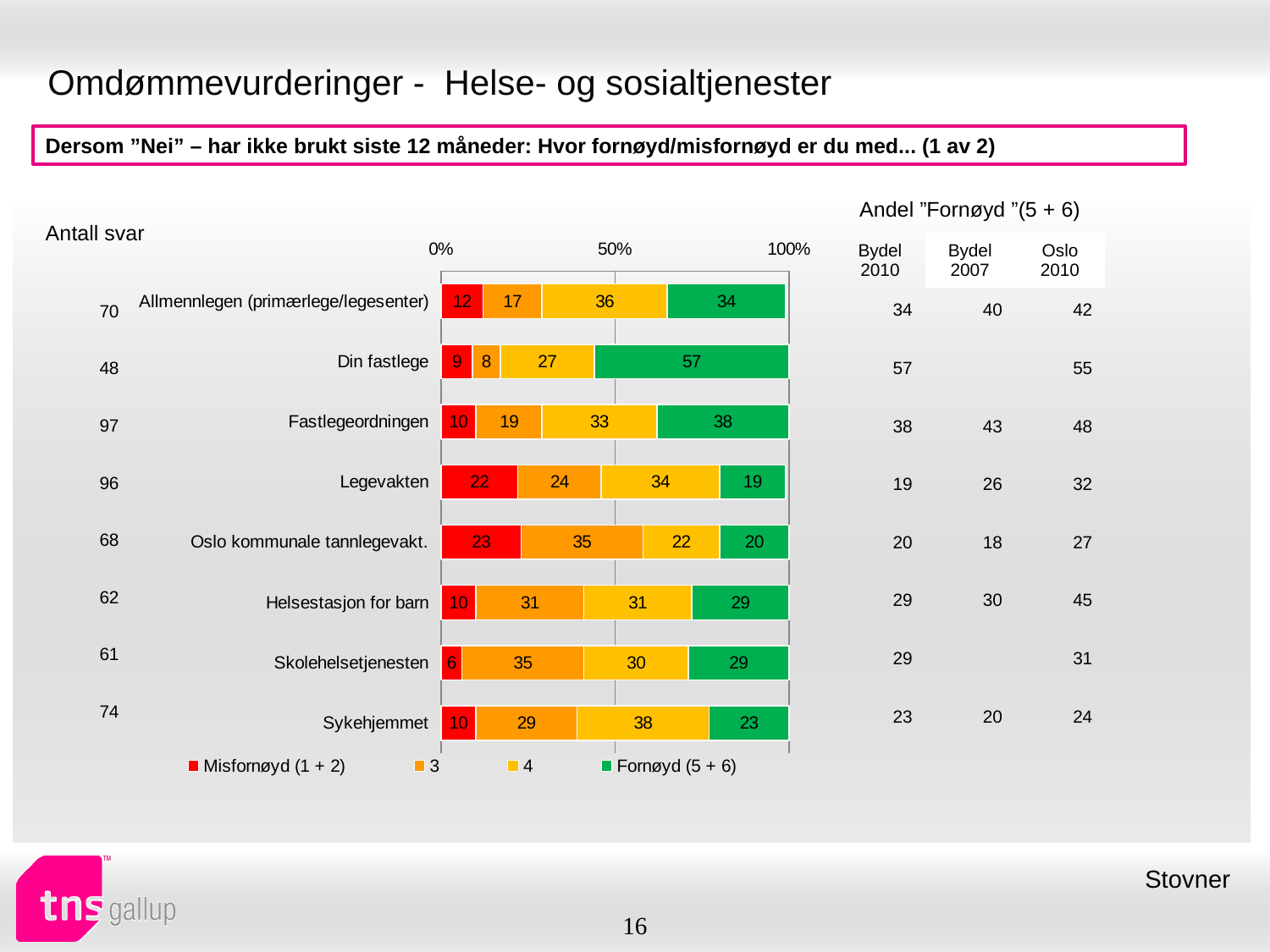
Which category has the lowest Misfornøyd (1 + 2) value? Skolehelsetjenesten Which has a larger Fornøyd (5 + 6) value, Fastlegeordningen or Helsestasjon for barn? Fastlegeordningen What is the value of the '3' segment for Skolehelsetjenesten? 35 What is the value of the '4' segment for Sykehjemmet? 38 What kind of chart is shown on the slide? Stacked bar chart What is the difference between the Fornøyd (5 + 6) values for Din fastlege and Allmennlegen (primærlege/legesenter)? 23 What is the value of the Fornøyd (5 + 6) segment for Din fastlege? 57 How many series does the legend list? 4 What is the value of the Misfornøyd (1 + 2) segment for Legevakten? 22 Which category has the highest Fornøyd (5 + 6) value? Din fastlege What colour represents the Fornøyd (5 + 6) series in the chart? Green How many categories are shown in the chart? 8